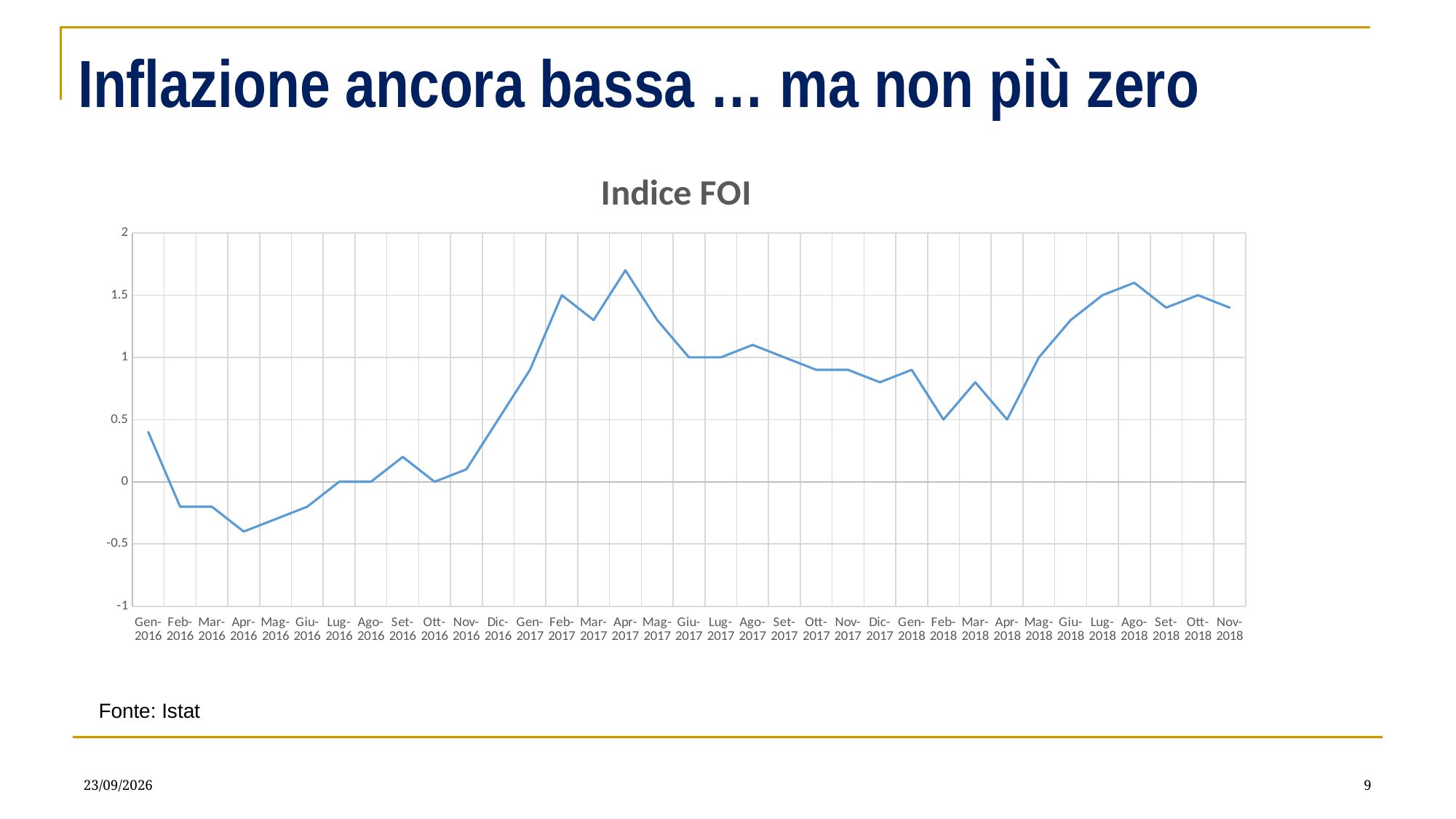
Which is larger, the value for Apr-2017 or the value for Apr-2016? Apr-2017 Which month has the lowest value on the chart? Apr-2016 Do the values rise or fall from Nov-2016 to Apr-2017? rise Which month has the highest value on the chart? Apr-2017 What kind of chart is shown on the slide? line chart What is the value for Giu-2017? 1 What is the value for Lug-2016? 0 Is the value for Dic-2017 greater or less than 1? less Is the value for Gen-2016 greater or less than 0? greater How many monthly data points are plotted on the chart? 35 What is the value for Feb-2018? 0.5 What is the title of the chart? Indice FOI